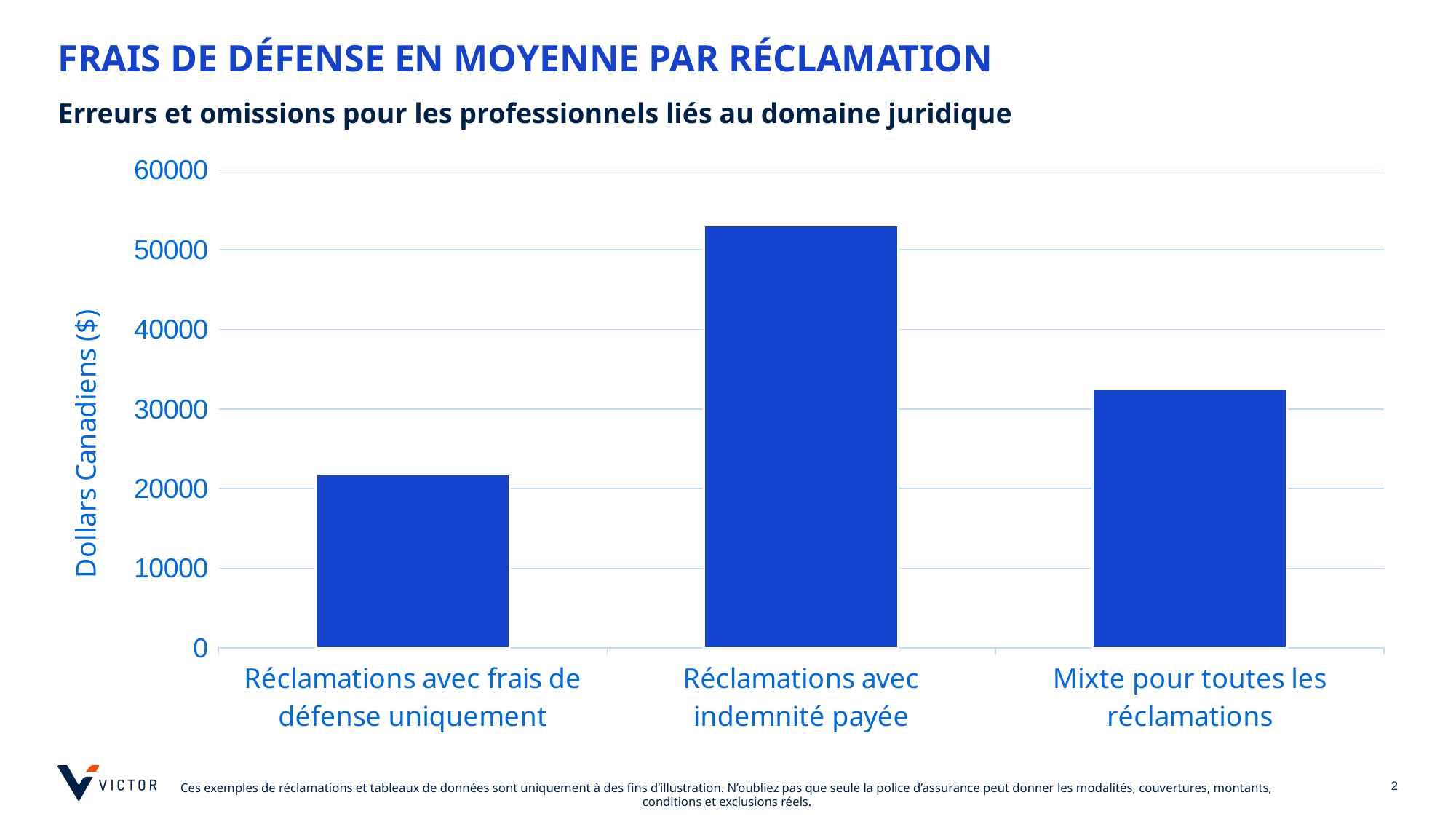
Is the value for 'Mixte pour toutes les réclamations' greater or less than 30000? greater Is the value for 'Réclamations avec frais de défense uniquement' greater or less than 30000? less What is the label of the y axis of the chart? Dollars Canadiens ($) How many categories are shown on the x axis of the chart? 3 Is the value for 'Mixte pour toutes les réclamations' greater or less than 40000? less Which category has the highest average defence cost? Réclamations avec indemnité payée Which is larger: the value for 'Mixte pour toutes les réclamations' or the value for 'Réclamations avec frais de défense uniquement'? Mixte pour toutes les réclamations Which category has the lowest average defence cost? Réclamations avec frais de défense uniquement What kind of chart is shown on the slide? bar chart What is the title of the slide containing the chart? FRAIS DE DÉFENSE EN MOYENNE PAR RÉCLAMATION Which is larger: the value for 'Réclamations avec indemnité payée' or the value for 'Mixte pour toutes les réclamations'? Réclamations avec indemnité payée